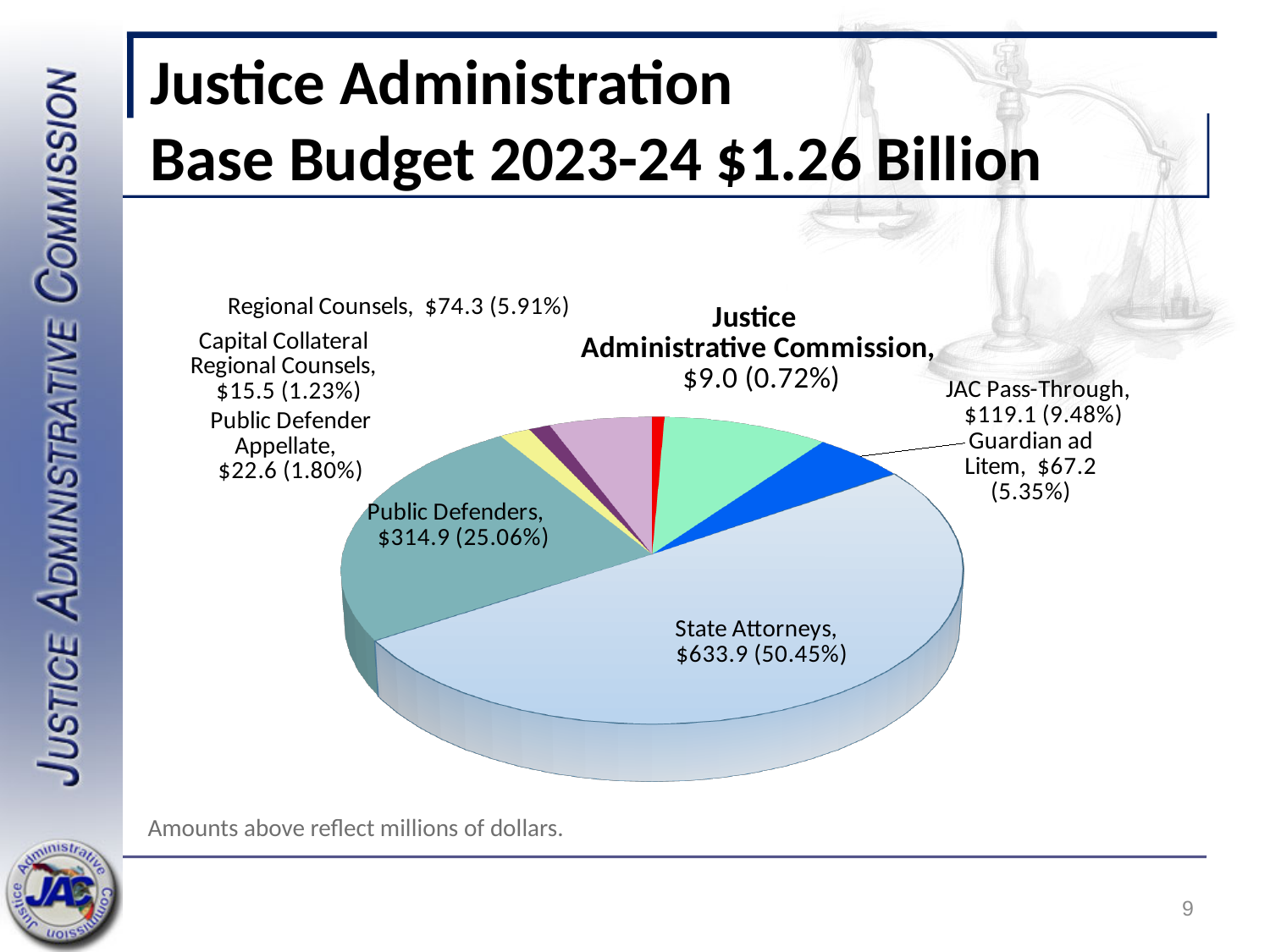
What is the value for State Attorneys? $633.9 Which category has the largest slice of the pie? State Attorneys What is the value for Guardian ad Litem? $67.2 What share of the pie does Regional Counsels represent? 5.91% What is the value for JAC Pass-Through? $119.1 How many slices does the pie chart have? 8 Which category has the smallest slice of the pie? Justice Administrative Commission What share of the pie does Public Defenders represent? 25.06% Which is larger, the value for Regional Counsels or the value for Guardian ad Litem? Regional Counsels What is the difference between the values for State Attorneys and Public Defenders? $319.0 What type of chart is shown on the slide? Pie chart What is the value for Public Defenders? $314.9